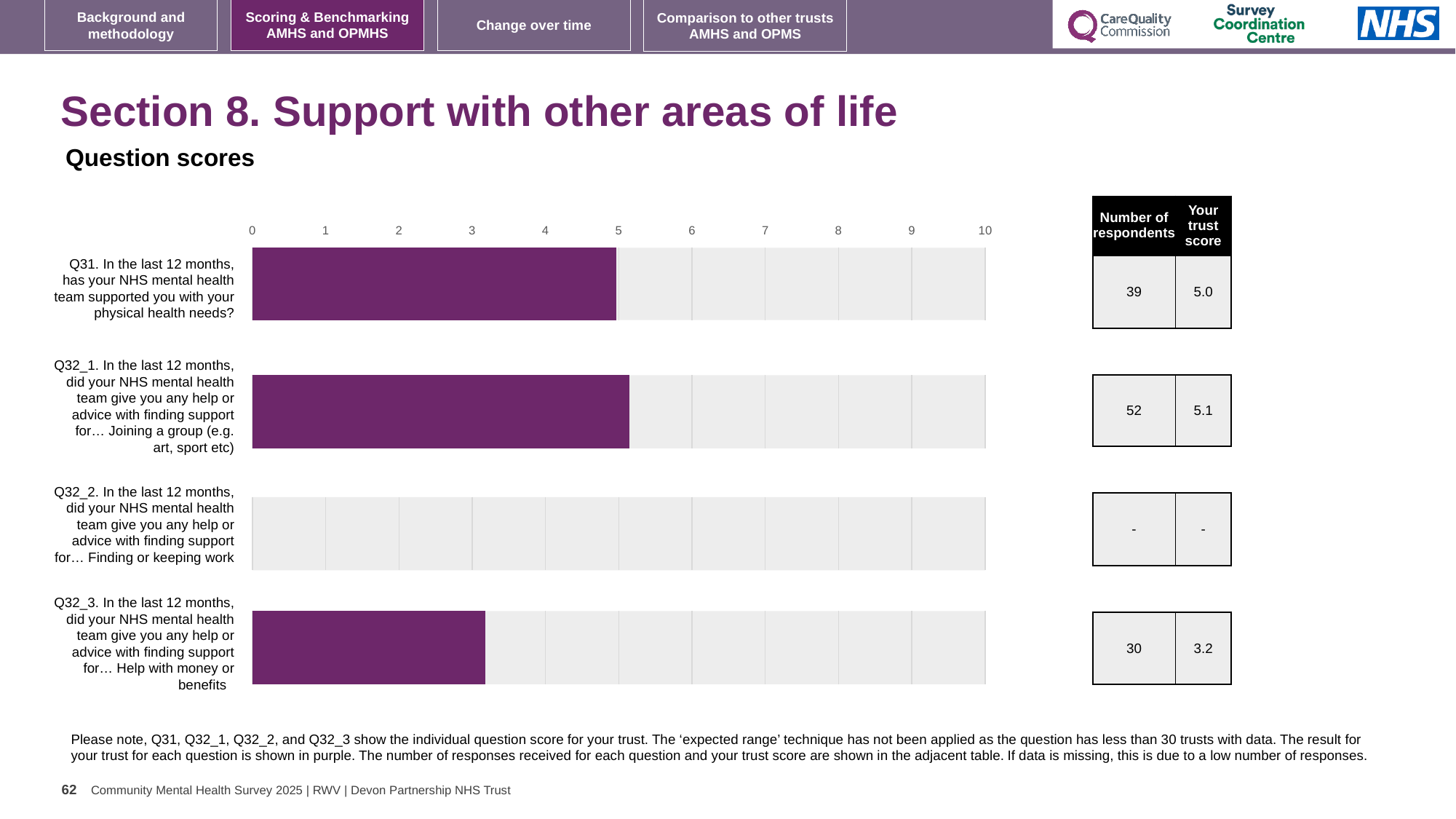
Which has the larger trust score, Q31 or Q32_3? Q31 Which question has the lowest trust score shown on the chart? Q32_3 Which question has no data shown (marked with a dash) in the table? Q32_2 How many respondents answered Q32_1? 52 What is the trust score for Q32_1 (help with joining a group)? 5.1 How many respondents answered Q32_3? 30 What is the difference between the trust scores for Q32_1 and Q32_3? 1.9 Is the value for Q32_3 greater or less than 4? less What is the trust score for Q31 (support with physical health needs)? 5.0 How many questions are listed on the chart? 4 What is the trust score for Q32_3 (help with money or benefits)? 3.2 What kind of chart is shown on the slide? Bar chart